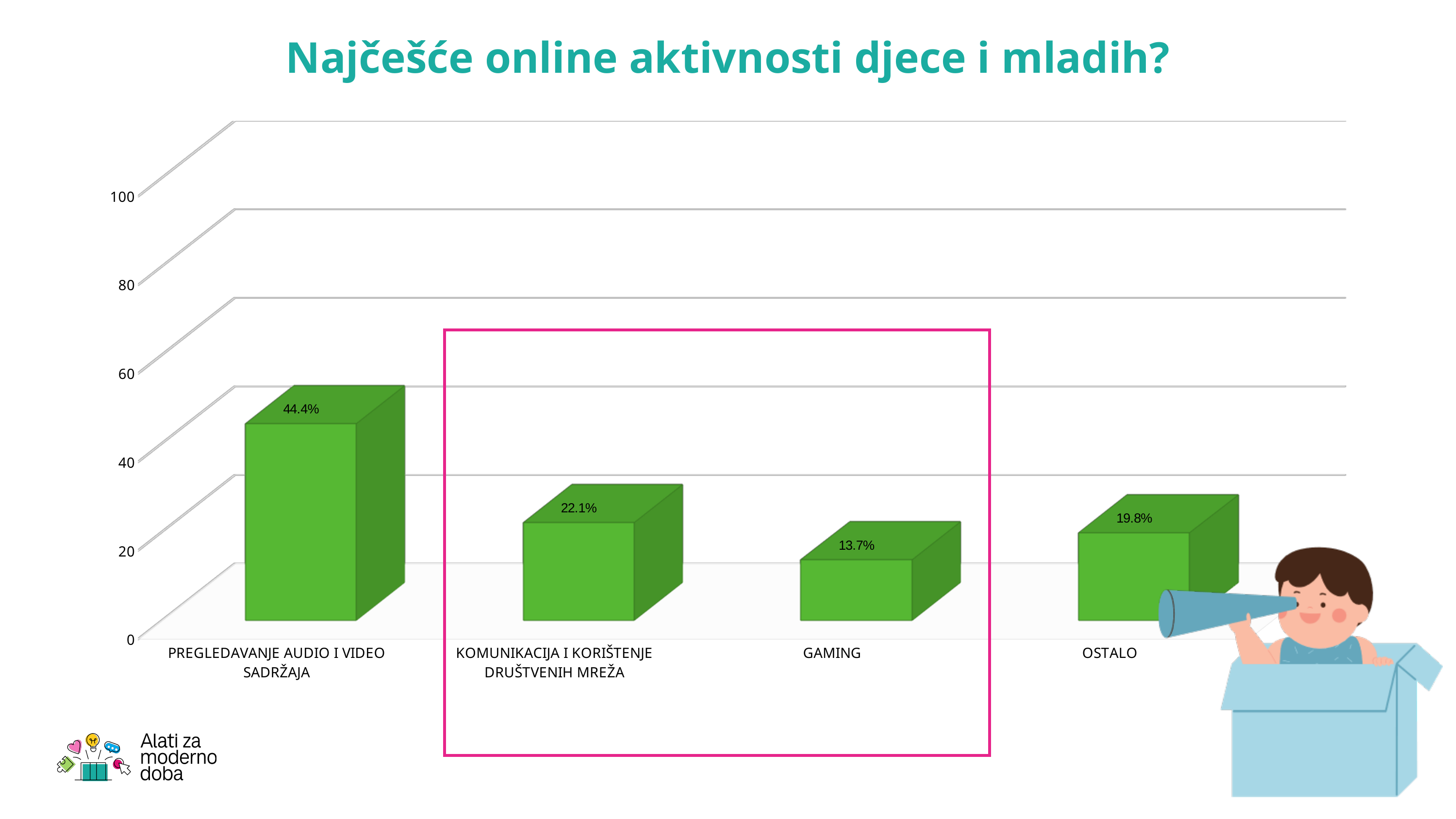
What kind of chart is shown on the slide? Bar chart How many categories are shown in the chart? 4 What is the difference between the values for PREGLEDAVANJE AUDIO I VIDEO SADRŽAJA and KOMUNIKACIJA I KORIŠTENJE DRUŠTVENIH MREŽA? 22.3% What is the difference between the values for OSTALO and GAMING? 6.1% What is the value for PREGLEDAVANJE AUDIO I VIDEO SADRŽAJA? 44.4% Which category has the lowest value? GAMING What is the value for OSTALO? 19.8% What is the title of the slide? Najčešće online aktivnosti djece i mladih? Which is larger, the value for KOMUNIKACIJA I KORIŠTENJE DRUŠTVENIH MREŽA or the value for OSTALO? KOMUNIKACIJA I KORIŠTENJE DRUŠTVENIH MREŽA Which category has the highest value? PREGLEDAVANJE AUDIO I VIDEO SADRŽAJA What is the value for KOMUNIKACIJA I KORIŠTENJE DRUŠTVENIH MREŽA? 22.1% What is the value for GAMING? 13.7%